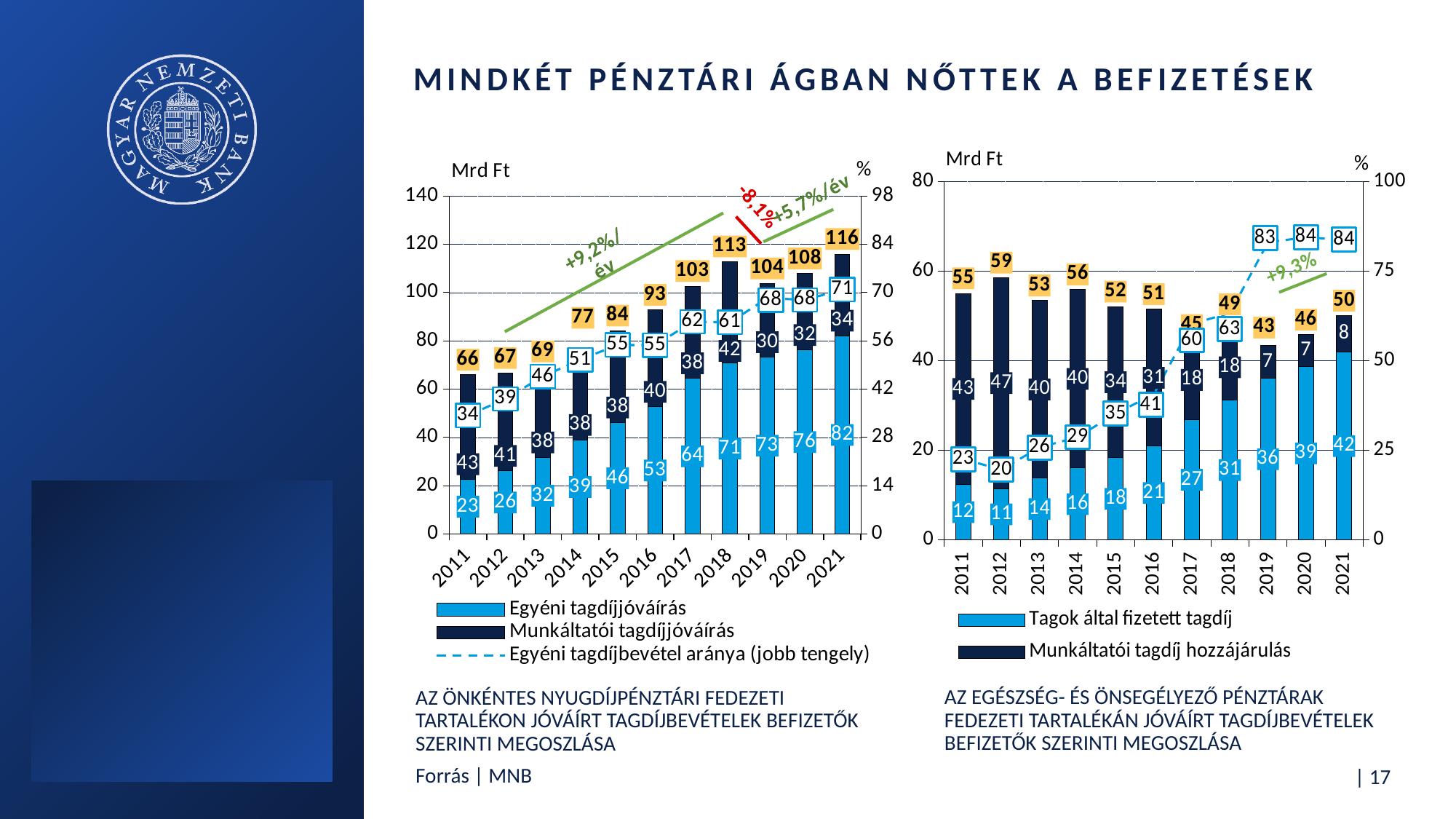
In the right chart, is the Tagok által fizetett tagdíj value larger in 2021 or in 2011? 2021 In the left chart, which year has the highest total stacked value? 2021 In the right chart, what is the value of Munkáltatói tagdíj hozzájárulás for 2012? 47 In the right chart, which year has the lowest total stacked value? 2019 What kind of chart is the right chart? Stacked bar chart with a line In the right chart, what is the total stacked value for 2014? 56 In the left chart, what is the difference between the Egyéni tagdíjjóváírás values for 2021 and 2011? 59 In the left chart, what is the value of Egyéni tagdíjjóváírás for 2021? 82 In the left chart, what is the total stacked value for 2018? 113 How many series does the legend of the left chart list? 3 How many years are shown on the x axis of the right chart? 11 In the left chart, what is the Egyéni tagdíjbevétel aránya (jobb tengely) value for 2019? 68